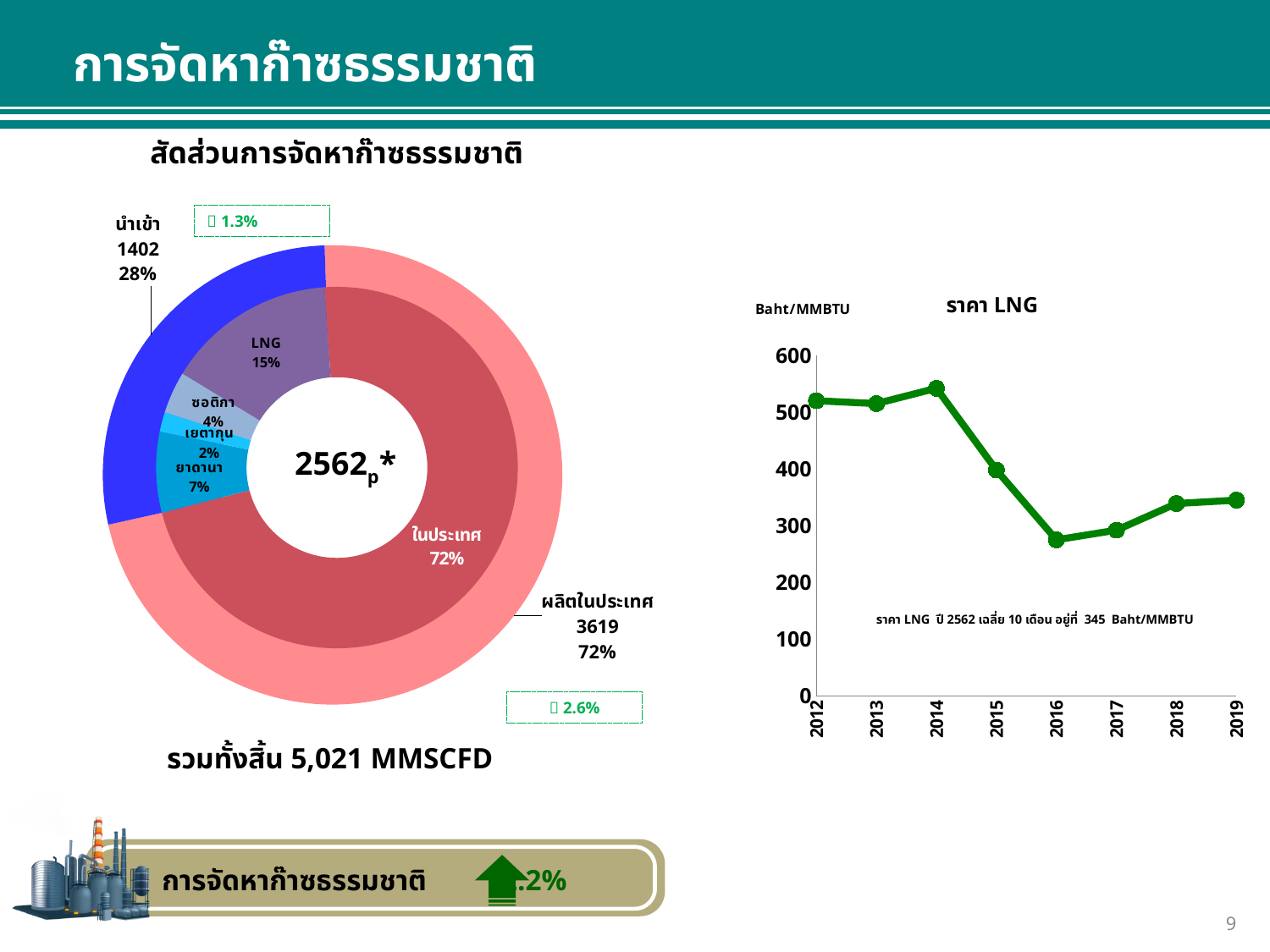
In the donut chart สัดส่วนการจัดหาก๊าซธรรมชาติ, what percentage share does LNG have? 15% What total is stated below the donut chart สัดส่วนการจัดหาก๊าซธรรมชาติ? 5,021 MMSCFD In the donut chart สัดส่วนการจัดหาก๊าซธรรมชาติ, which has the larger share, ยาดานา or ซอติกา? ยาดานา In the donut chart สัดส่วนการจัดหาก๊าซธรรมชาติ, what is the difference between the ผลิตในประเทศ value and the นำเข้า value? 2217 In the ราคา LNG chart, which year has the highest LNG price? 2014 In the donut chart สัดส่วนการจัดหาก๊าซธรรมชาติ, what is the value shown for นำเข้า (imports)? 1402 In the ราคา LNG chart, what is the average LNG price for 2562 over 10 months, as stated in the annotation? 345 Baht/MMBTU In the donut chart สัดส่วนการจัดหาก๊าซธรรมชาติ, what percentage share does ผลิตในประเทศ (domestic production) have? 72% In the ราคา LNG chart, is the value for 2016 greater or less than 300? less In the donut chart สัดส่วนการจัดหาก๊าซธรรมชาติ, which import source has the smallest share? เยตากุน What type of chart is the ราคา LNG chart on the right? Line chart In the ราคา LNG chart, how many years are plotted on the x axis? 8